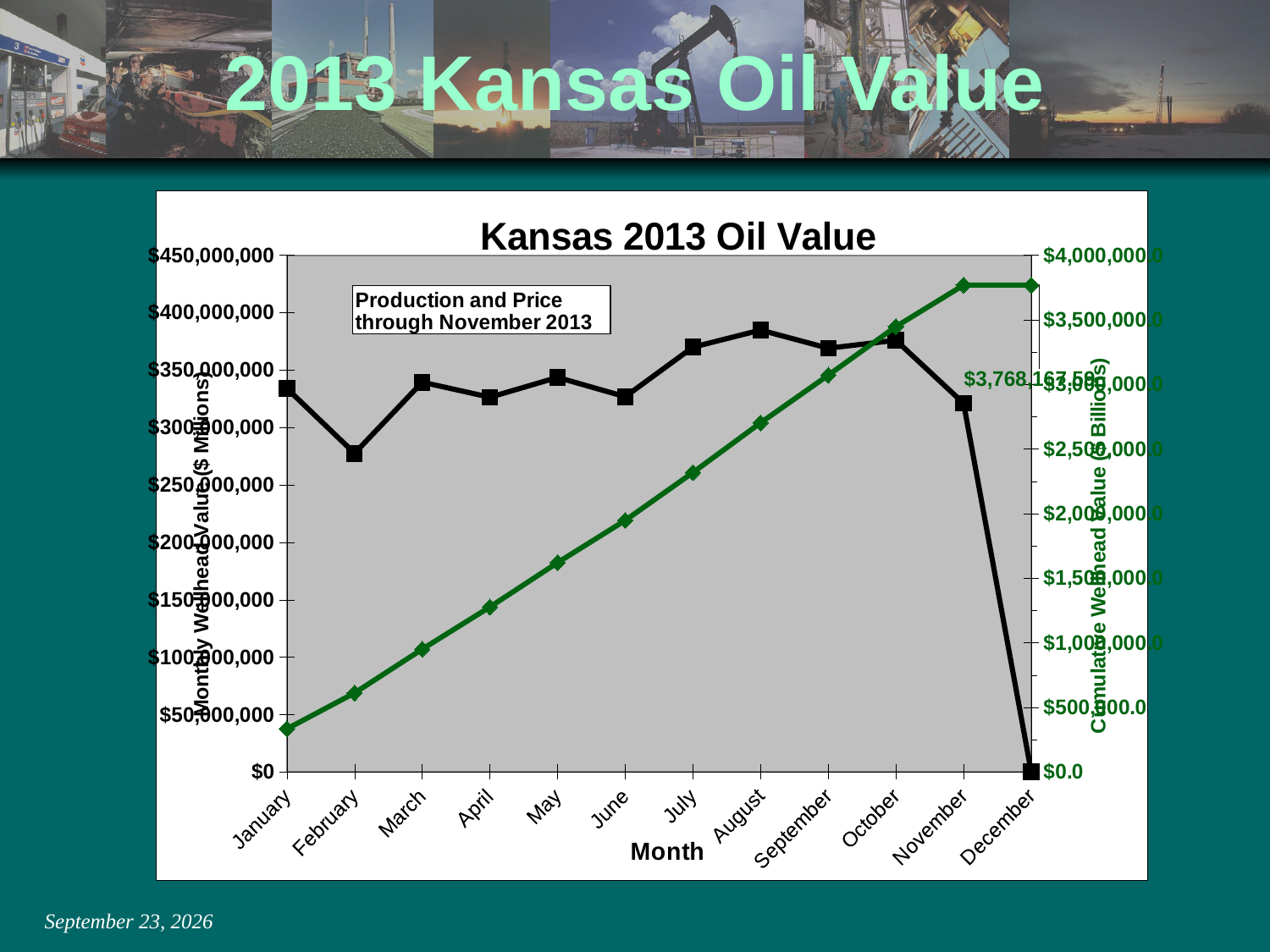
Which month has the larger monthly wellhead value, February or March? March Does the cumulative wellhead value (green line) rise or fall from January to November? rise What is the monthly wellhead value plotted for December? $0 In which month is the monthly wellhead value (black line) highest? August Is the cumulative wellhead value for May greater or less than $2,000,000.0? less How many months are plotted along the x axis? 12 What kind of chart is shown on the slide? line chart In which month is the monthly wellhead value (black line) lowest? December Is the cumulative wellhead value for November greater or less than $3,500,000.0? greater Is the monthly wellhead value for January greater or less than $300,000,000? greater What is the title of the chart? Kansas 2013 Oil Value